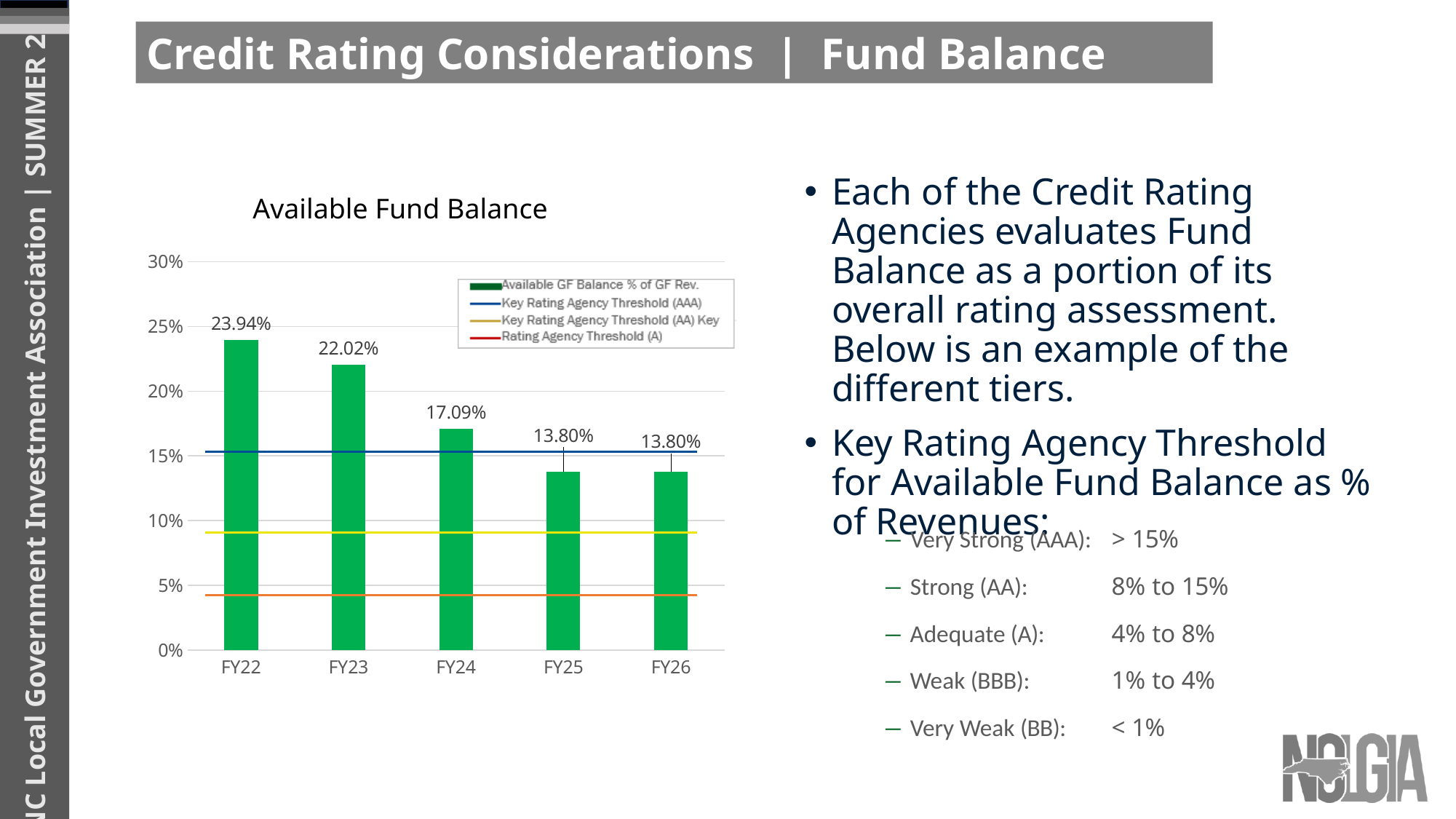
How many fiscal years are shown on the x axis of the Available Fund Balance chart? 5 Do the Available GF Balance % of GF Rev. values rise or fall from FY22 to FY26? Fall What is the Available GF Balance % of GF Rev. for FY24? 17.09% What is the Available GF Balance % of GF Rev. for FY22? 23.94% How many entries does the legend of the Available Fund Balance chart list? 4 What kind of chart is the Available Fund Balance chart? Bar chart Which fiscal year has the highest Available GF Balance % of GF Rev.? FY22 Is the Available GF Balance % of GF Rev. for FY25 greater or less than 15%? less Which is larger, the Available GF Balance % of GF Rev. for FY23 or for FY24? FY23 What is the difference between the FY24 and FY25 values for Available GF Balance % of GF Rev.? 3.29 percentage points What is the difference between the FY22 and FY23 values for Available GF Balance % of GF Rev.? 1.92 percentage points What is the Available GF Balance % of GF Rev. for FY26? 13.80%